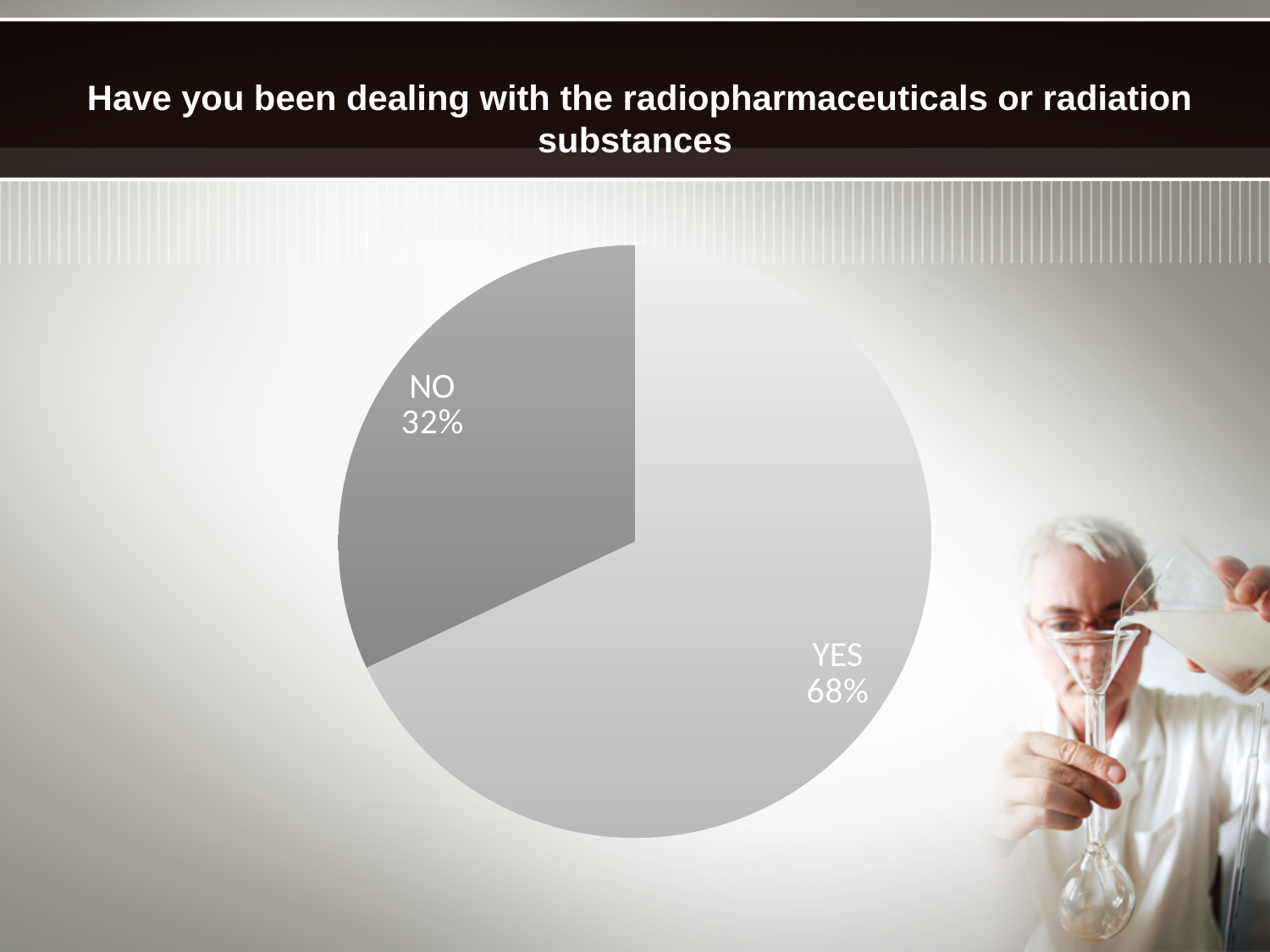
Which is larger, the YES share or the NO share? YES What is the difference in percentage points between the YES and NO shares? 36 How many slices does the pie chart have? 2 What percentage of respondents answered NO? 32% Which response has the largest share of the pie? YES What type of chart is shown on the slide? pie chart What share of the pie does the NO slice represent? 32% Which response has the smallest share of the pie? NO Which slice of the pie is shaded darker, YES or NO? NO What percentage of respondents answered YES? 68% What is the title of the slide containing the pie chart? Have you been dealing with the radiopharmaceuticals or radiation substances